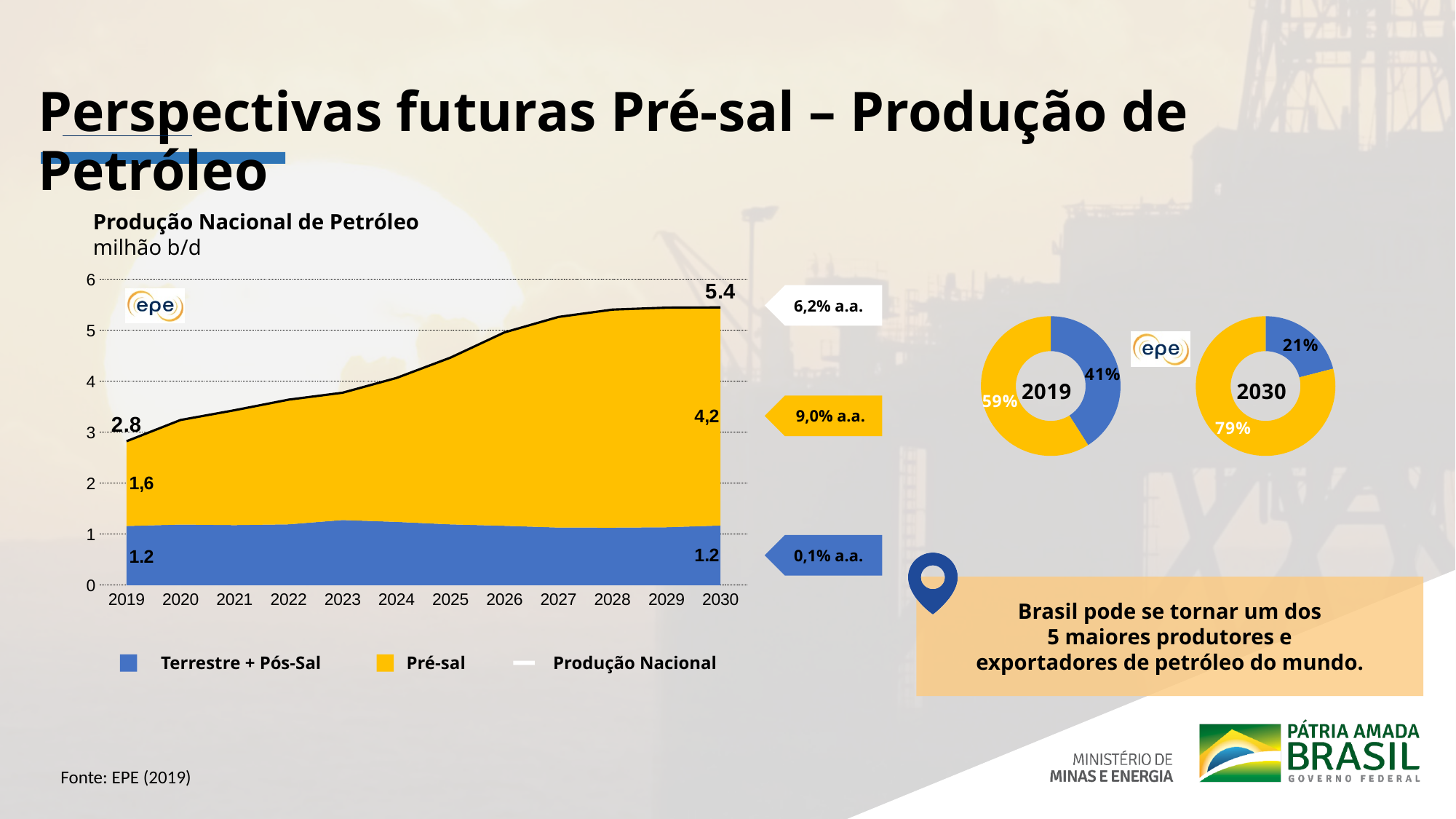
In the 'Produção Nacional de Petróleo' chart, how many years are shown on the x axis? 12 In the 'Produção Nacional de Petróleo' chart, what is the annual growth rate shown for Pré-sal? 9,0% a.a. In the 'Produção Nacional de Petróleo' chart, what is the Pré-sal value labelled for 2019? 1,6 In the 2030 donut chart on the right, what share is shown for the yellow (Pré-sal) slice? 79% In the 'Produção Nacional de Petróleo' chart, what is the Produção Nacional value labelled for 2019? 2.8 In the 'Produção Nacional de Petróleo' chart, what is the Pré-sal value labelled for 2030? 4,2 In the 'Produção Nacional de Petróleo' chart, which series is larger in 2030, Pré-sal or Terrestre + Pós-Sal? Pré-sal In the 2019 donut chart on the right, what share is shown for the blue slice? 41% In the 'Produção Nacional de Petróleo' chart, how many series does the legend list? 3 In the 'Produção Nacional de Petróleo' chart, what is the Produção Nacional value labelled for 2030? 5.4 In the 'Produção Nacional de Petróleo' chart, does the Produção Nacional line rise or fall from 2019 to 2030? rise In the 'Produção Nacional de Petróleo' chart, what is the Terrestre + Pós-Sal value labelled for 2030? 1.2